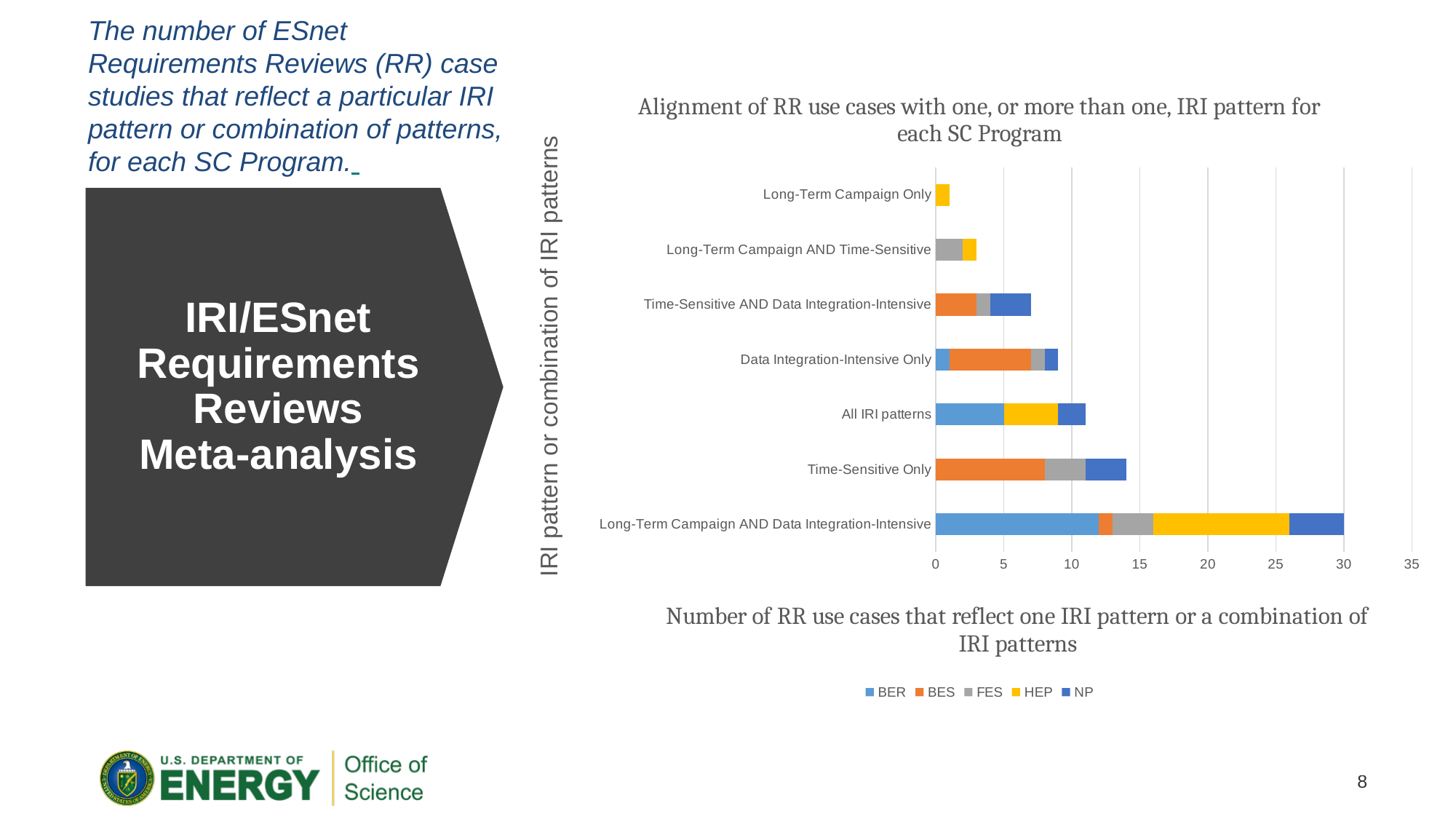
Which IRI pattern category has the shortest total bar? Long-Term Campaign Only Which has a larger total bar, Data Integration-Intensive Only or Time-Sensitive AND Data Integration-Intensive? Data Integration-Intensive Only Which series is shown in yellow in the legend? HEP Which IRI pattern category has the longest total bar? Long-Term Campaign AND Data Integration-Intensive Is the total value for Long-Term Campaign AND Data Integration-Intensive greater or less than 25? greater What kind of chart is shown on the slide? stacked bar chart How many series does the legend list? 5 How many IRI pattern categories are plotted on the y axis? 7 Is the total value for Long-Term Campaign AND Time-Sensitive greater or less than 5? less Is the total value for Time-Sensitive Only greater or less than 10? greater Which has a larger total bar, Time-Sensitive Only or All IRI patterns? Time-Sensitive Only What is the label of the x axis? Number of RR use cases that reflect one IRI pattern or a combination of IRI patterns